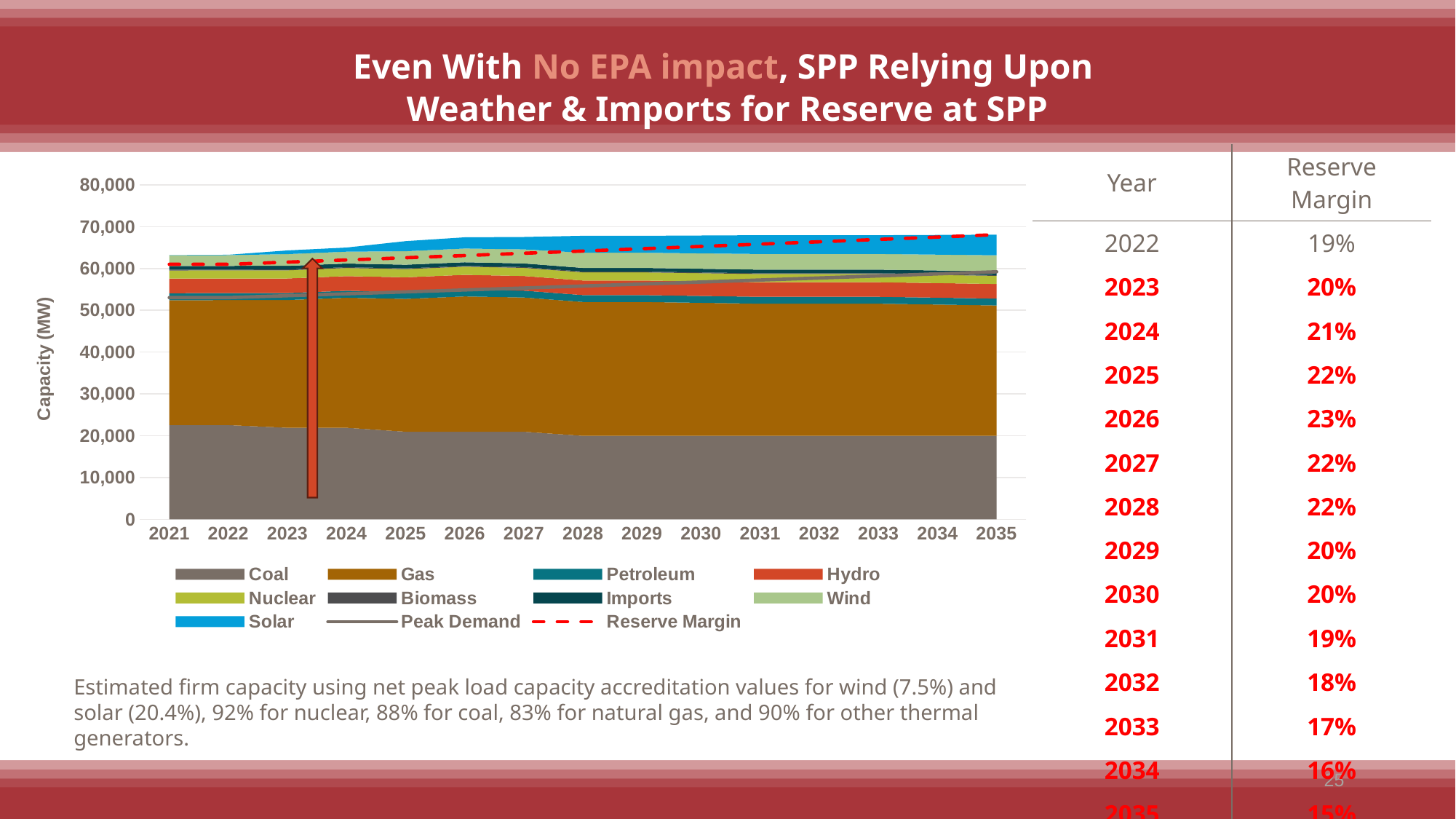
How many years are shown along the x axis of the chart? 15 What is the highest value shown on the chart's vertical axis? 80,000 Does the Coal capacity rise or fall from 2021 to 2035? fall How many entries does the chart's legend list? 11 Is the total stacked capacity in 2035 greater or less than 70,000 MW? less Is the Coal capacity in 2021 greater or less than 20,000 MW? greater What is the label of the chart's vertical axis? Capacity (MW) Which series occupies the largest area of the stacked chart? Gas What kind of chart is shown on the slide? Stacked area chart Is the total stacked capacity in 2021 greater or less than 60,000 MW? greater Does the total stacked capacity rise or fall from 2021 to 2035? rise